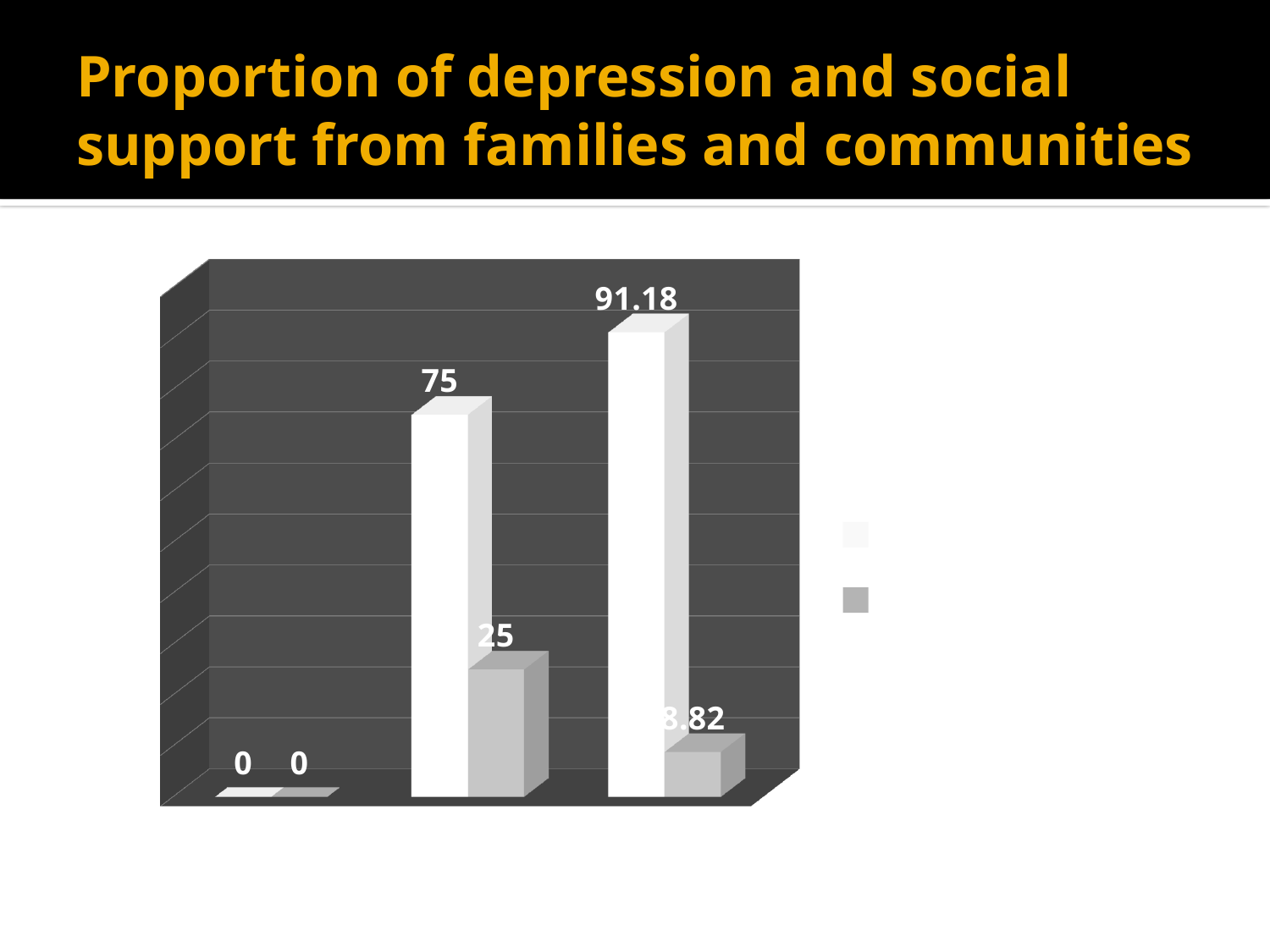
What is the value of the grey bar in the middle group? 25 What is the difference between the white and grey bars in the middle group? 50 How many groups of bars are plotted in the chart? 3 Do the white bars rise or fall from left to right across the groups? rise What kind of chart is shown on the slide? bar chart What is the value of the grey bar in the rightmost group? 8.82 What is the value of the white bar in the rightmost group? 91.18 What are the values of the two bars in the leftmost group? 0 and 0 Which is larger: the grey bar in the middle group or the grey bar in the rightmost group? the grey bar in the middle group Which bar has the highest value in the chart? the white bar in the rightmost group (91.18) How many series does the legend list? 2 What is the value of the white bar in the middle group? 75